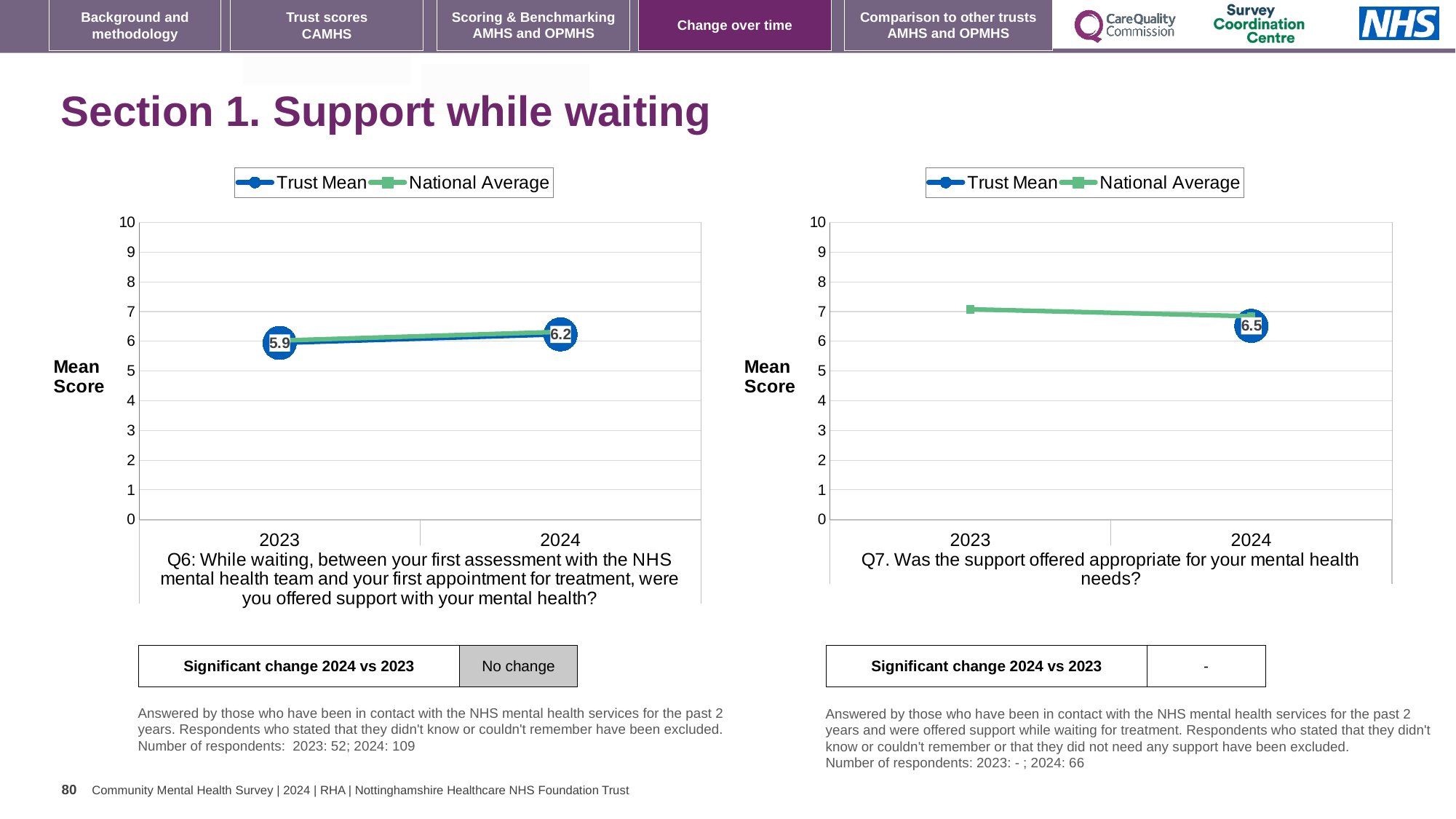
In the right chart (Q7), is the Trust Mean for 2024 greater or less than 7? less In the right chart (Q7), is the National Average for 2023 greater or less than 8? less In the left chart (Q6), does the Trust Mean rise or fall from 2023 to 2024? rise In the left chart (Q6), what is the Trust Mean for 2023? 5.9 What kind of chart is the left chart (Q6)? line chart In the left chart (Q6), what is the Trust Mean for 2024? 6.2 How many years are shown on the x axis of the left chart (Q6)? 2 In the right chart (Q7), what is the Trust Mean for 2024? 6.5 In the left chart (Q6), by how much did the Trust Mean change from 2023 to 2024? 0.3 How many series does the legend of the right chart (Q7) list? 2 What is the y-axis label on the left chart (Q6)? Mean Score In the left chart (Q6), which year has the higher Trust Mean, 2023 or 2024? 2024